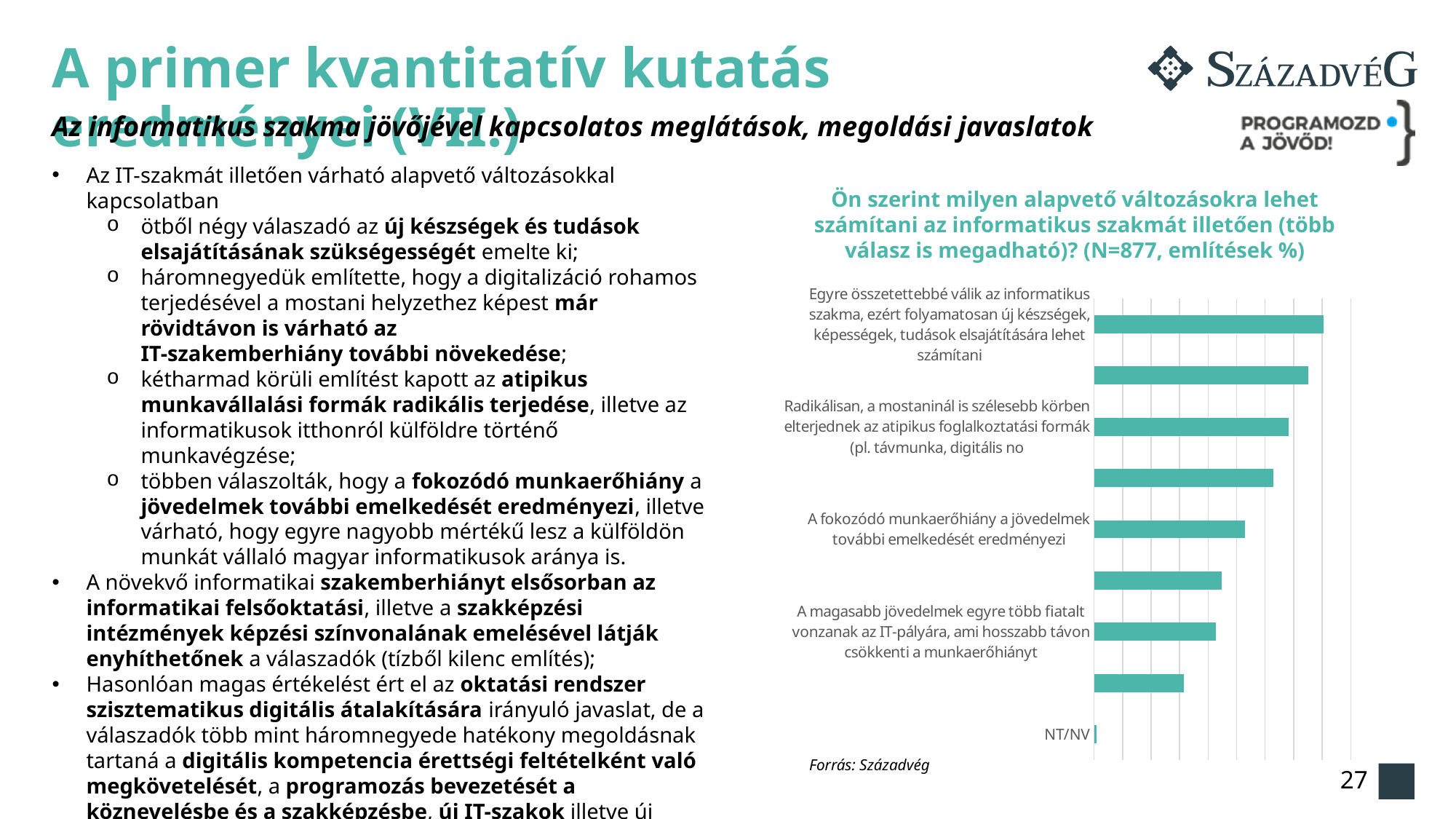
Which is larger: the value for 'A fokozódó munkaerőhiány a jövedelmek további emelkedését eredményezi' or the value for 'NT/NV'? A fokozódó munkaerőhiány a jövedelmek további emelkedését eredményezi What kind of chart is shown on the slide? bar chart Which category has the lowest value in the chart? NT/NV Do the bar lengths increase or decrease going from the top of the chart to the bottom? decrease What is the sample size (N) stated in the chart title? 877 How many bars does the chart contain? 9 Which is larger: the value for 'Radikálisan, a mostaninál is szélesebb körben elterjednek az atipikus foglalkoztatási formák...' or the value for 'A magasabb jövedelmek egyre több fiatalt vonzanak az IT-pályára...'? Radikálisan, a mostaninál is szélesebb körben elterjednek az atipikus foglalkoztatási formák... Which is larger: the value for 'Egyre összetettebbé válik az informatikus szakma...' or the value for 'A fokozódó munkaerőhiány a jövedelmek további emelkedését eredményezi'? Egyre összetettebbé válik az informatikus szakma... Which category has the highest value in the chart? Egyre összetettebbé válik az informatikus szakma, ezért folyamatosan új készségek, képességek, tudások elsajátítására lehet számítani What source is cited below the chart? Századvég